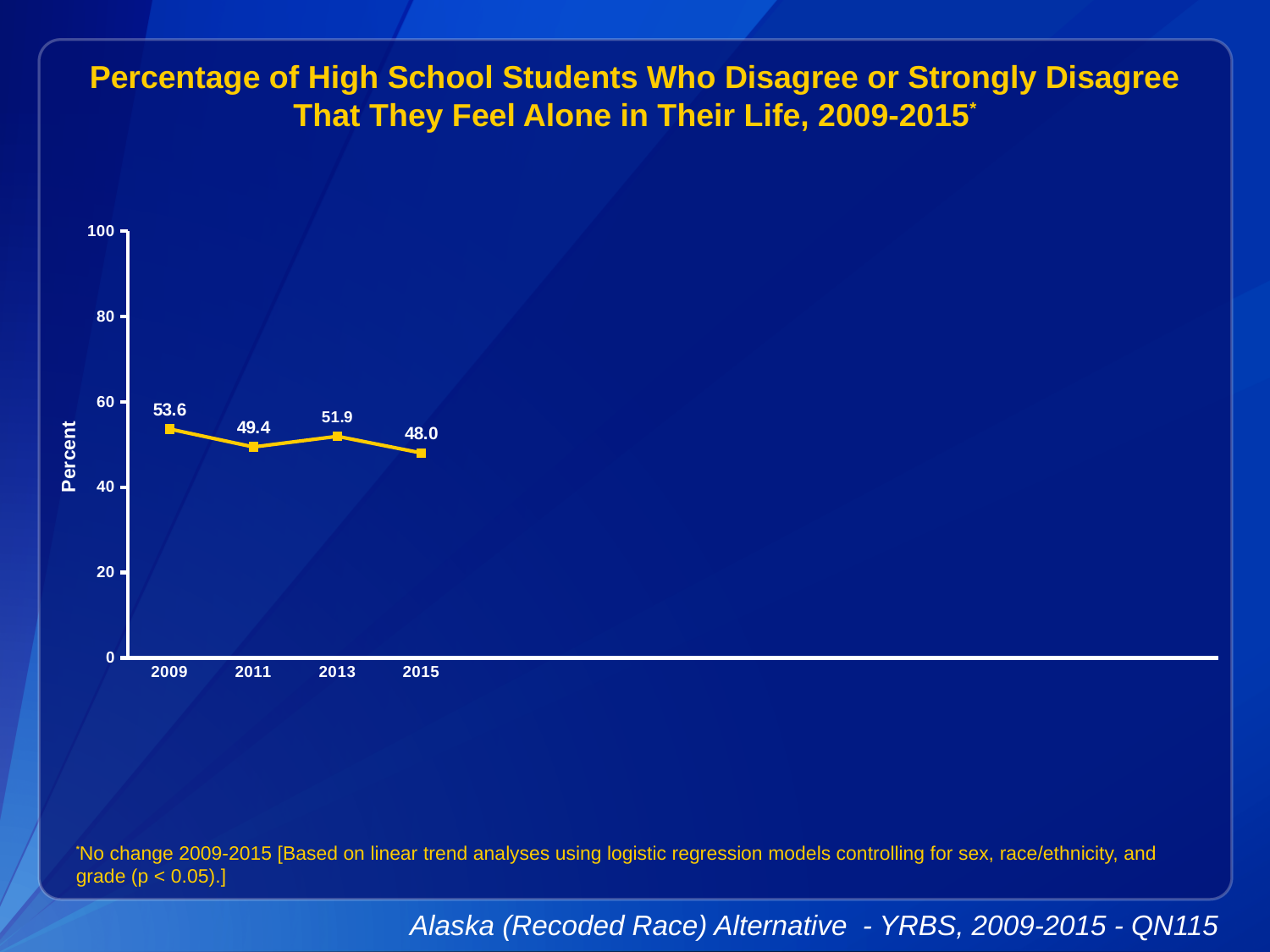
What is the value for 2009? 53.6 Which is larger, the value for 2011 or the value for 2013? 2013 Is the value for 2009 greater or less than 60? less What kind of chart is shown? line chart What is the difference between the values for 2009 and 2015? 5.6 How many years are plotted on the chart? 4 Which year has the highest value? 2009 What is the value for 2013? 51.9 Which year has the lowest value? 2015 What is the value for 2011? 49.4 What is the value for 2015? 48.0 What is the label on the vertical axis? Percent